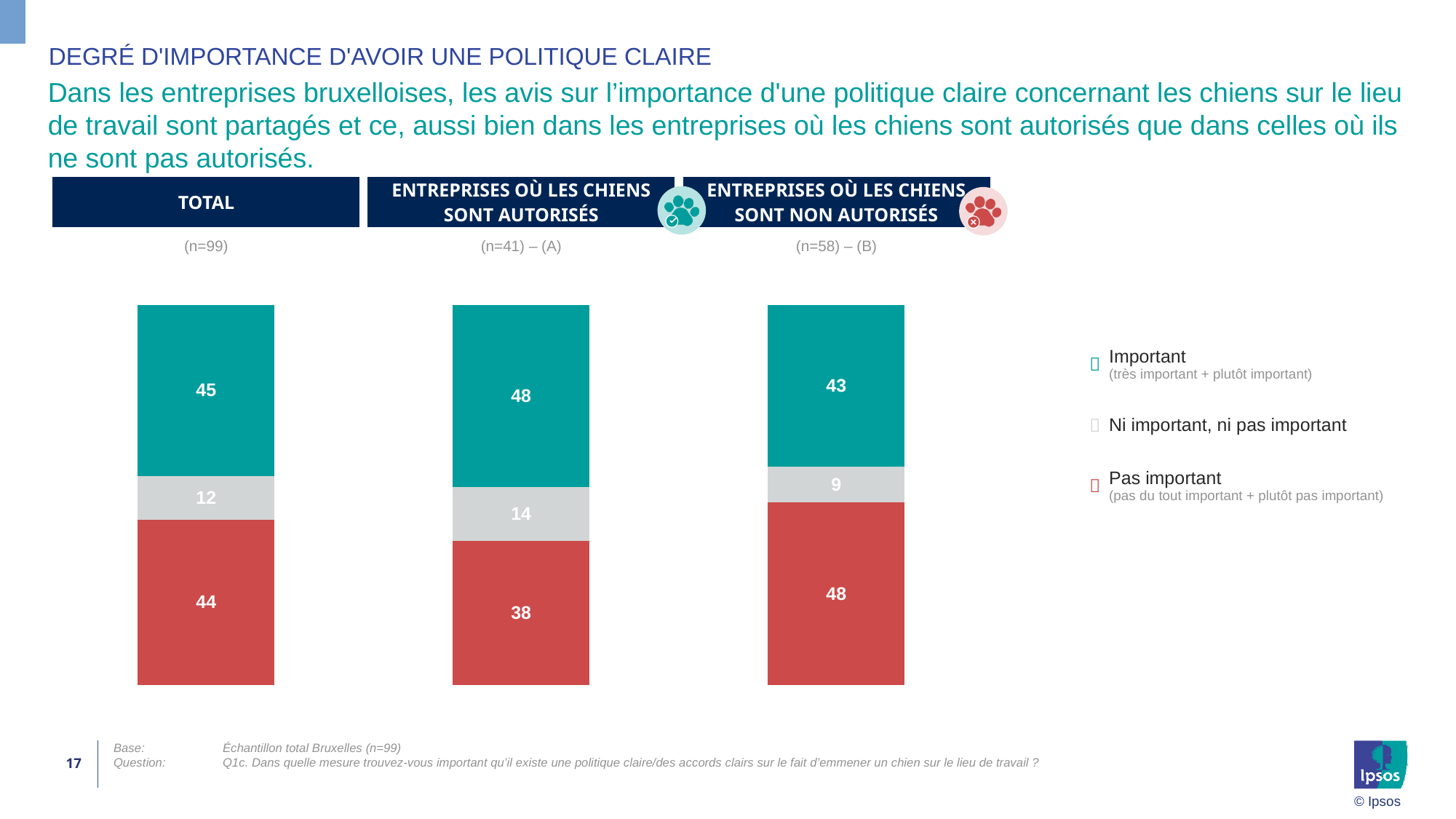
What is the difference between the "Pas important" values for entreprises où les chiens sont non autorisés and entreprises où les chiens sont autorisés? 10 In the TOTAL bar, which is larger: "Important" or "Pas important"? Important How many stacked bars are shown on the slide? 3 What is the value for "Important" in the TOTAL bar? 45 What is the value for "Important" in the bar for entreprises où les chiens sont non autorisés? 43 What is the value for "Pas important" in the bar for entreprises où les chiens sont autorisés? 38 What kind of chart is shown on the slide? Stacked bar chart Which bar has the highest value for "Important"? Entreprises où les chiens sont autorisés What is the sample size shown for the TOTAL bar? n=99 What is the value for "Ni important, ni pas important" in the bar for entreprises où les chiens sont non autorisés? 9 Which bar has the lowest value for "Ni important, ni pas important"? Entreprises où les chiens sont non autorisés How many series does the legend list? 3